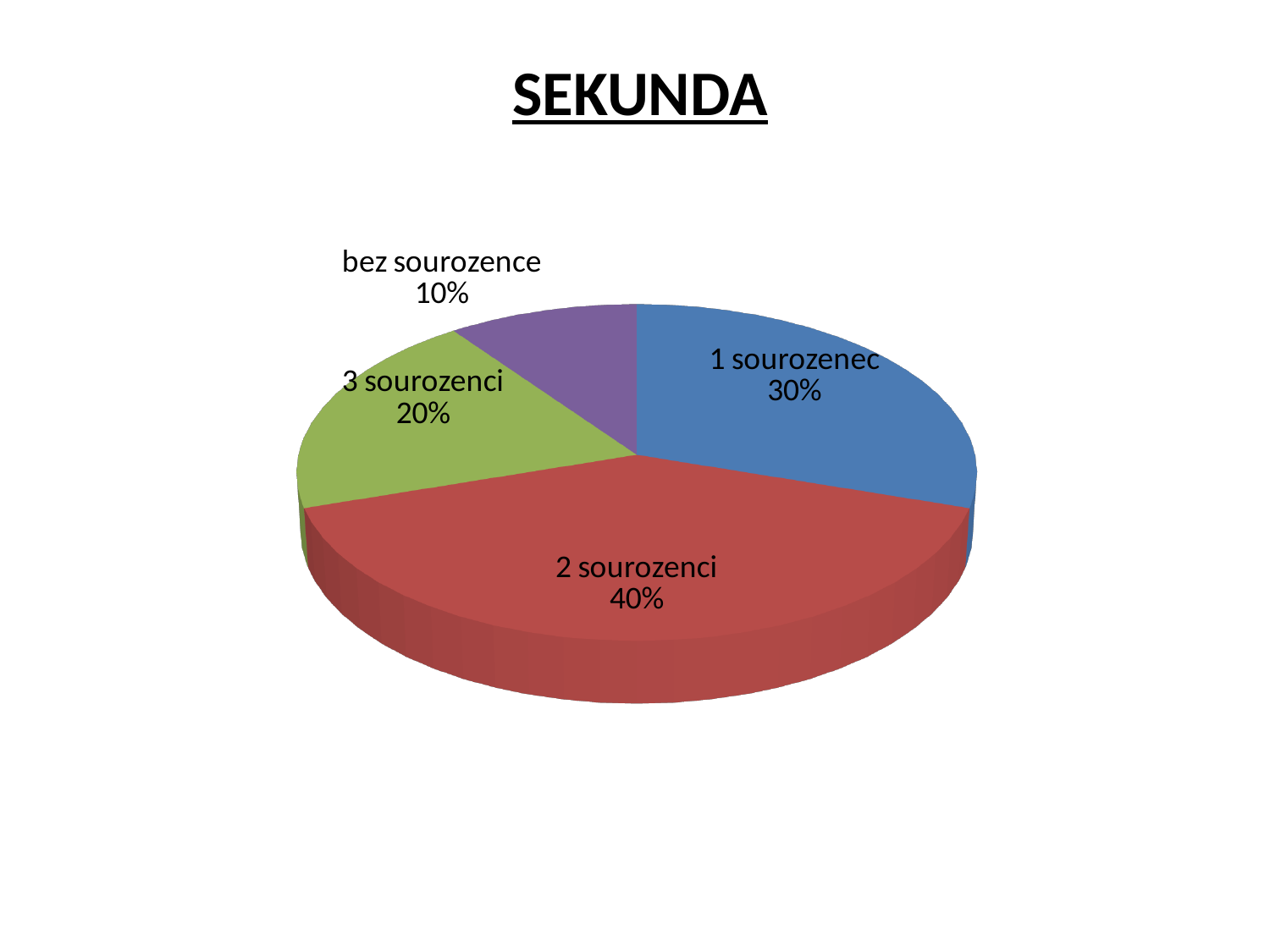
Which is larger, the share for "1 sourozenec" or the share for "3 sourozenci"? 1 sourozenec How many slices does the pie chart have? 4 Which category has the smallest slice of the pie? bez sourozence What colour is the slice for "2 sourozenci"? red What is the title of the slide containing the pie chart? SEKUNDA Which category has the largest slice of the pie? 2 sourozenci What type of chart is shown on the slide? pie chart What share of the pie does "1 sourozenec" represent? 30% What share of the pie does "bez sourozence" represent? 10% What share of the pie does "3 sourozenci" represent? 20% What is the difference in percentage points between "2 sourozenci" and "3 sourozenci"? 20%